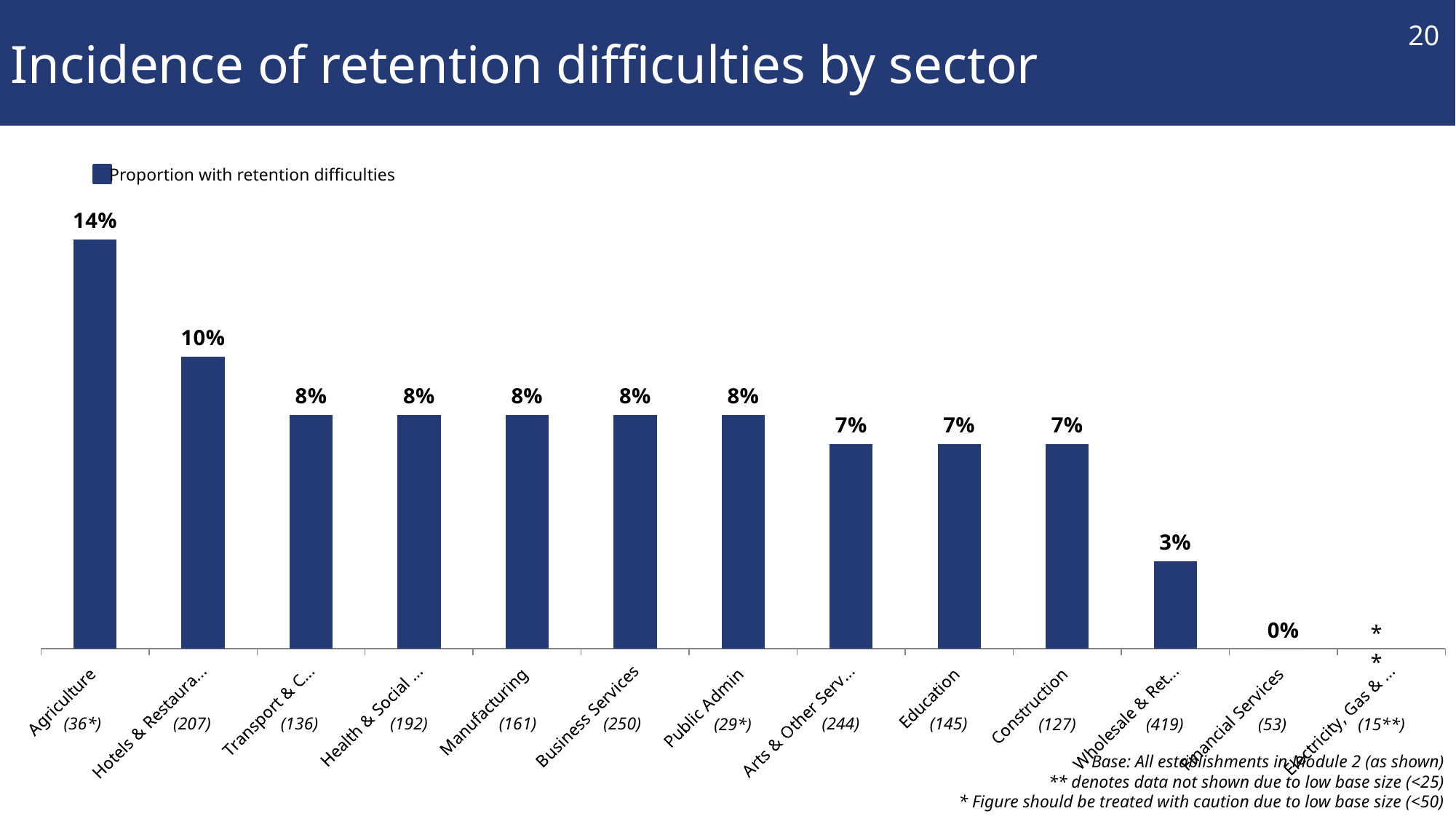
How many sectors are listed along the x axis? 13 Which sector has the lowest proportion with retention difficulties among those with a value shown? Financial Services Which has a higher proportion with retention difficulties, Business Services or Education? Business Services What is the proportion with retention difficulties for Manufacturing? 8% What kind of chart is shown on the slide? Bar chart What is the difference between the proportion for Agriculture and the proportion for Construction? 7% Which sector has the highest proportion with retention difficulties? Agriculture What is the proportion with retention difficulties for Education? 7% How many series does the legend list? 1 What is the base size shown for Public Admin? (29*) What is the proportion with retention difficulties for Agriculture? 14% What is the proportion with retention difficulties for Financial Services? 0%